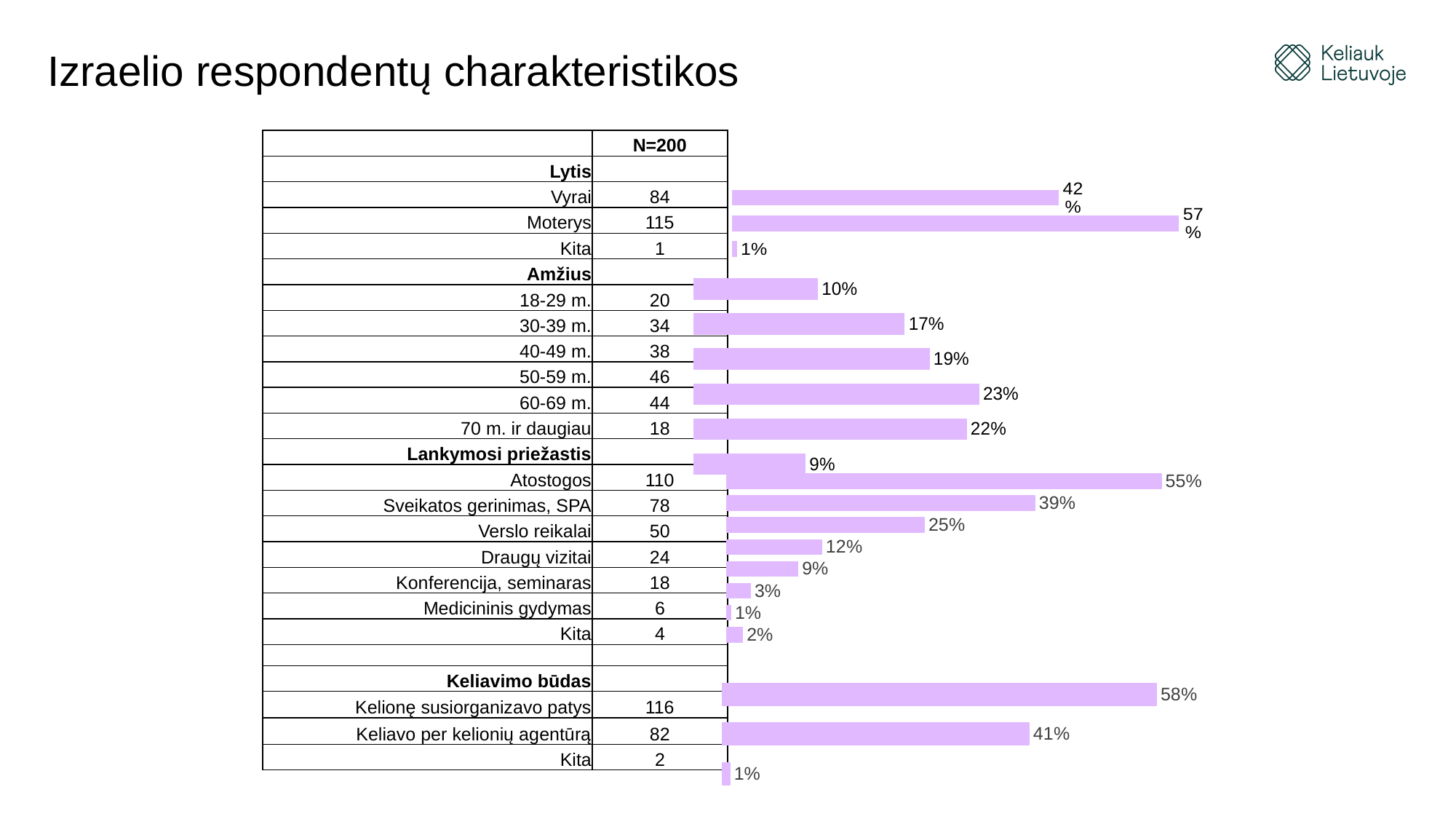
In the Lytis (gender) chart, what percentage is shown for Moterys? 57% In the Keliavimo būdas (travel method) chart, what is the difference in percentage points between Kelionę susiorganizavo patys and Keliavo per kelionių agentūrą? 17 In the Amžius (age) chart, which age group has the highest percentage? 50-59 m. In the Amžius (age) chart, what percentage is shown for 30-39 m.? 17% In the Lankymosi priežastis (reason for visit) chart, which is larger: Sveikatos gerinimas, SPA or Verslo reikalai? Sveikatos gerinimas, SPA In the Lytis (gender) chart, what percentage is shown for Vyrai? 42% In the Lankymosi priežastis (reason for visit) chart, what percentage is shown for Draugų vizitai? 12% In the Keliavimo būdas (travel method) chart, which category has the lowest percentage? Kita In the Lankymosi priežastis (reason for visit) chart, what percentage is shown for Atostogos? 55% What type of chart is used on this slide to show the respondent characteristics? Bar chart In the Amžius (age) chart, what is the difference in percentage points between 50-59 m. and 18-29 m.? 13 In the Keliavimo būdas (travel method) chart, what percentage is shown for Kelionę susiorganizavo patys? 58%